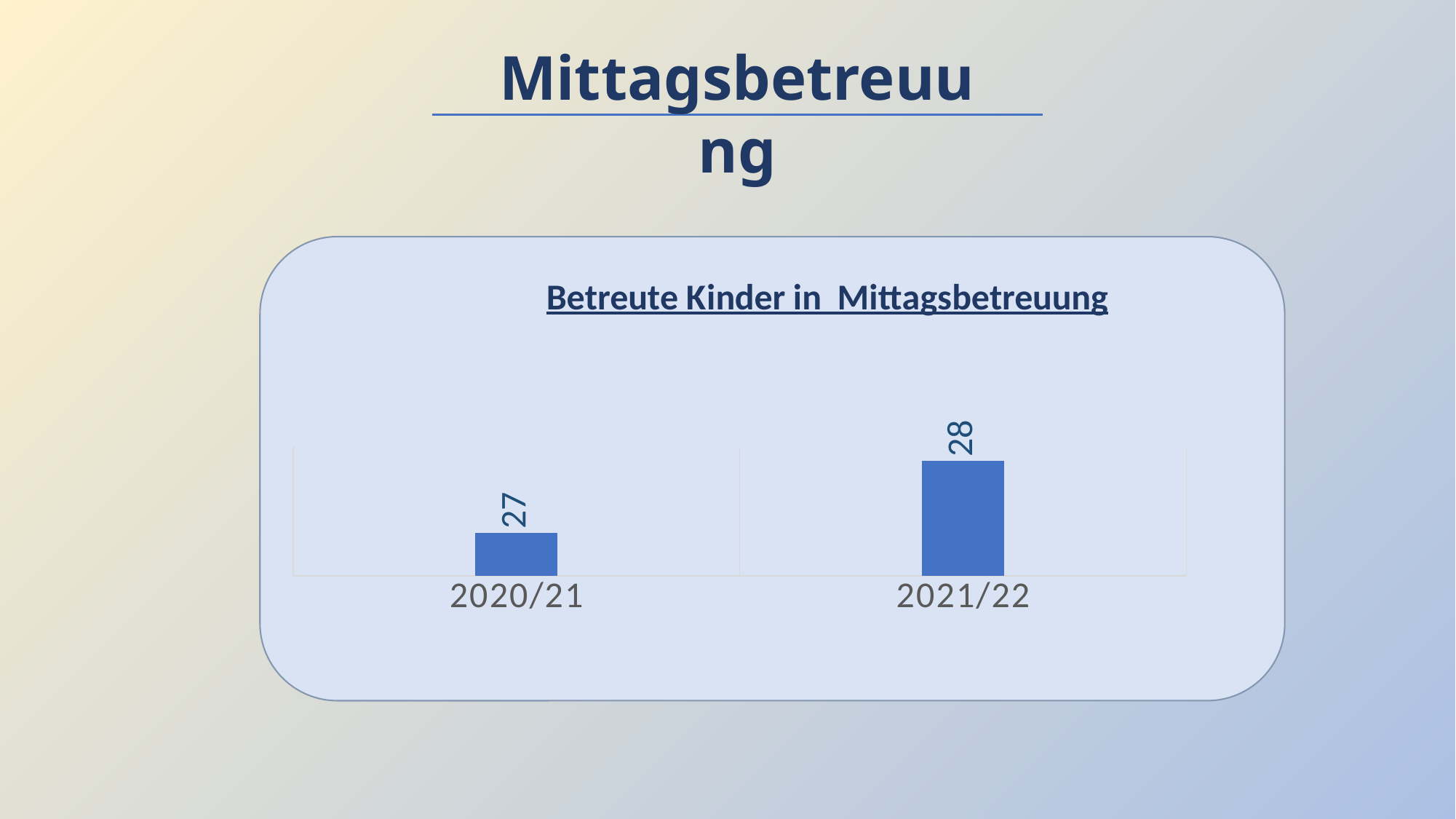
What is the title of the chart? Betreute Kinder in Mittagsbetreuung Do the values rise or fall from 2020/21 to 2021/22? rise How many categories are shown on the x axis? 2 What kind of chart is shown on the slide? bar chart Which category has the highest value? 2021/22 Which is larger, the value for 2020/21 or the value for 2021/22? 2021/22 Which category has the lowest value? 2020/21 What is the difference between the values for 2021/22 and 2020/21? 1 What is the value for 2020/21? 27 What is the value for 2021/22? 28 What colour are the bars in the chart? blue